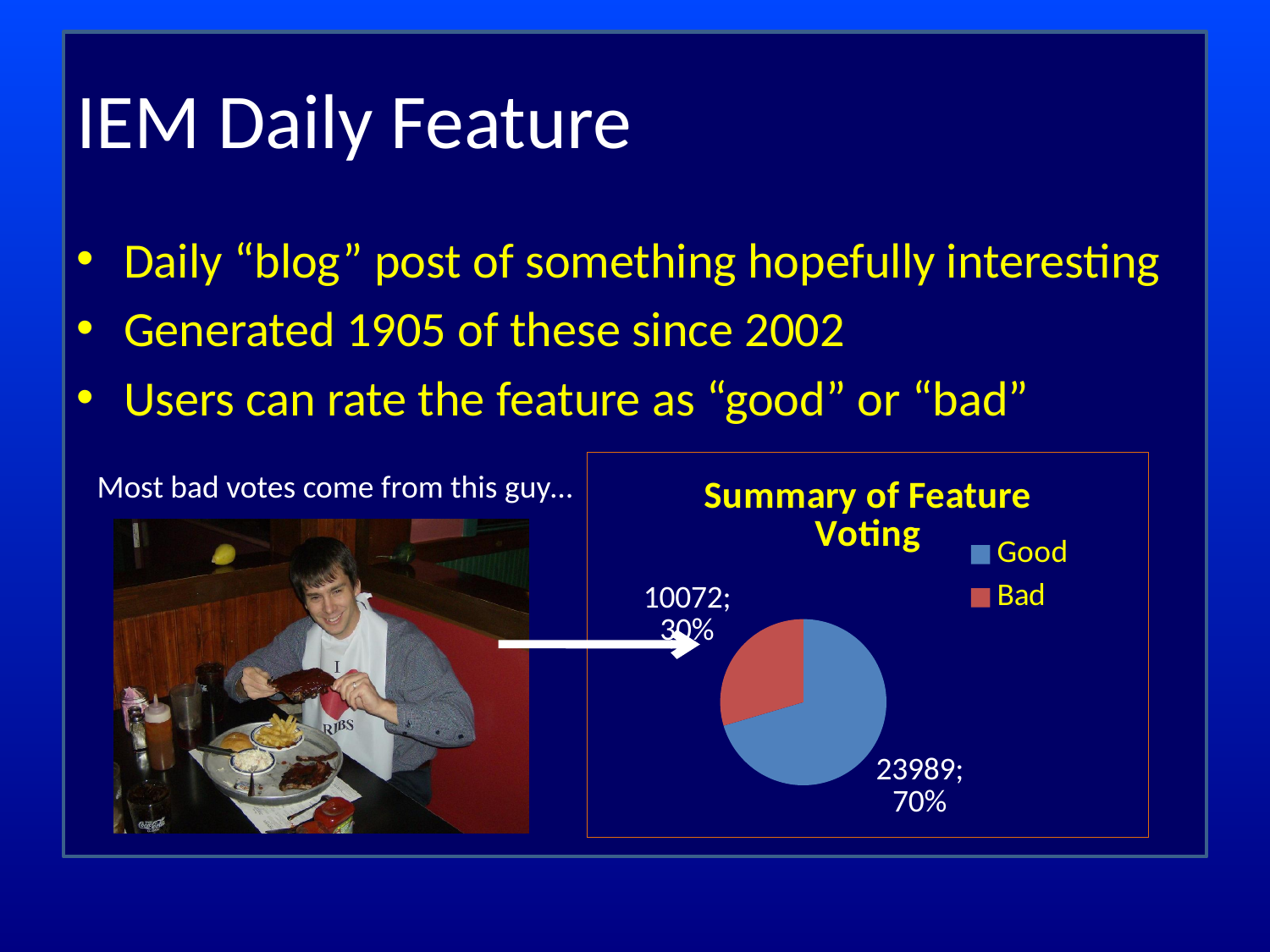
How many votes does the Bad slice represent? 10072 Which category has the largest slice of the pie? Good What is the title of the chart? Summary of Feature Voting What share of the pie is the Bad slice? 30% How many votes does the Good slice represent? 23989 How many entries does the chart legend list? 2 What kind of chart is shown on the slide? pie chart Which category has the smallest slice of the pie? Bad How many slices does the pie chart have? 2 What colour is the Bad slice in the pie chart? red How many more votes are Good than Bad? 13917 What share of the pie is the Good slice? 70%